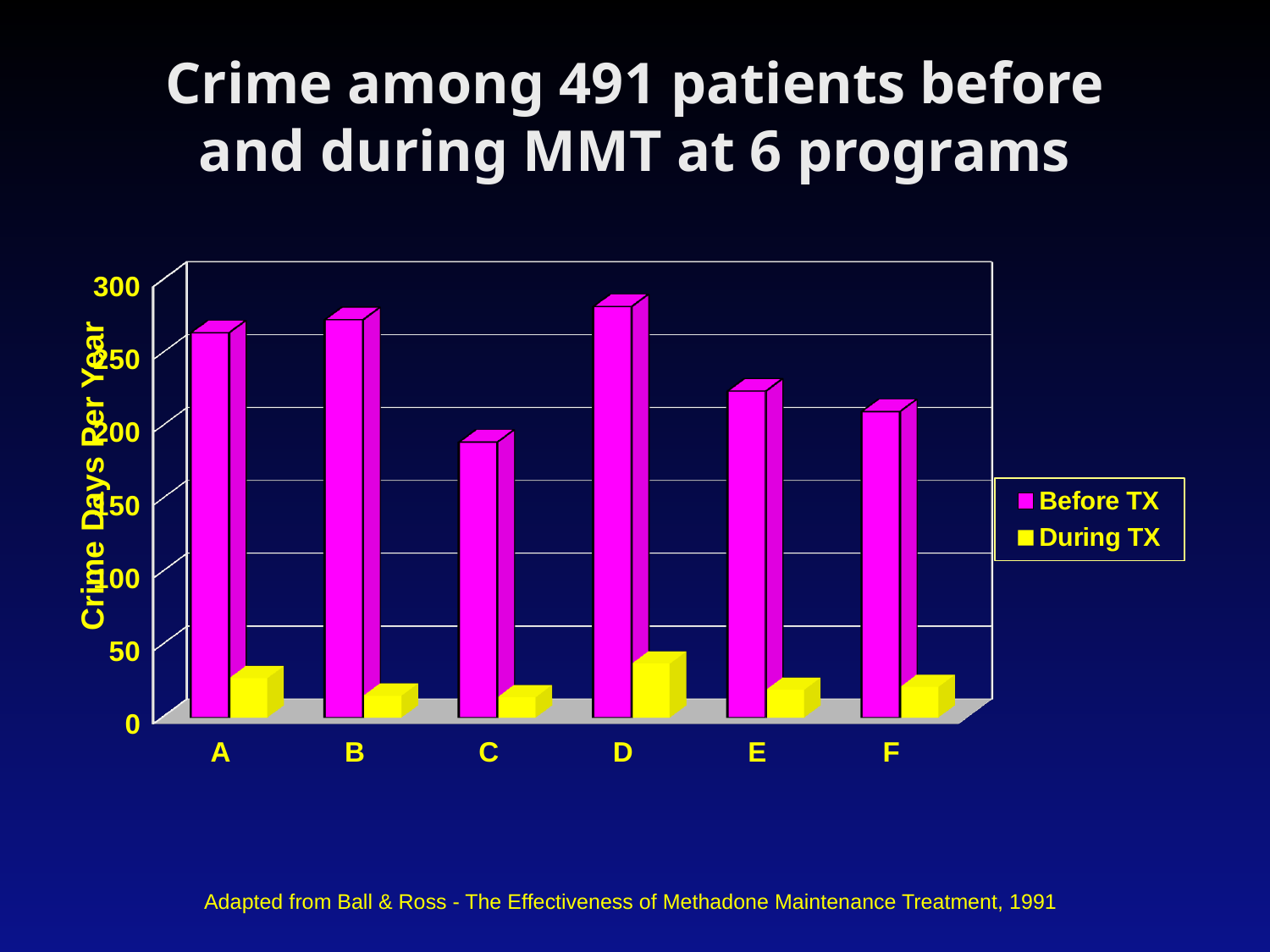
How many programs (categories) are shown on the x axis? 6 Which program has the highest Before TX value? D Is the During TX value for program D greater or less than 50? less Which program has the highest During TX value? D How many series does the legend list? 2 Which is larger, the Before TX value for program B or for program E? B Which program has the lowest Before TX value? C Is the Before TX value for program A greater or less than 250? greater Is the Before TX value for program C greater or less than 200? less What colour are the During TX bars? yellow What kind of chart is shown on the slide? bar chart